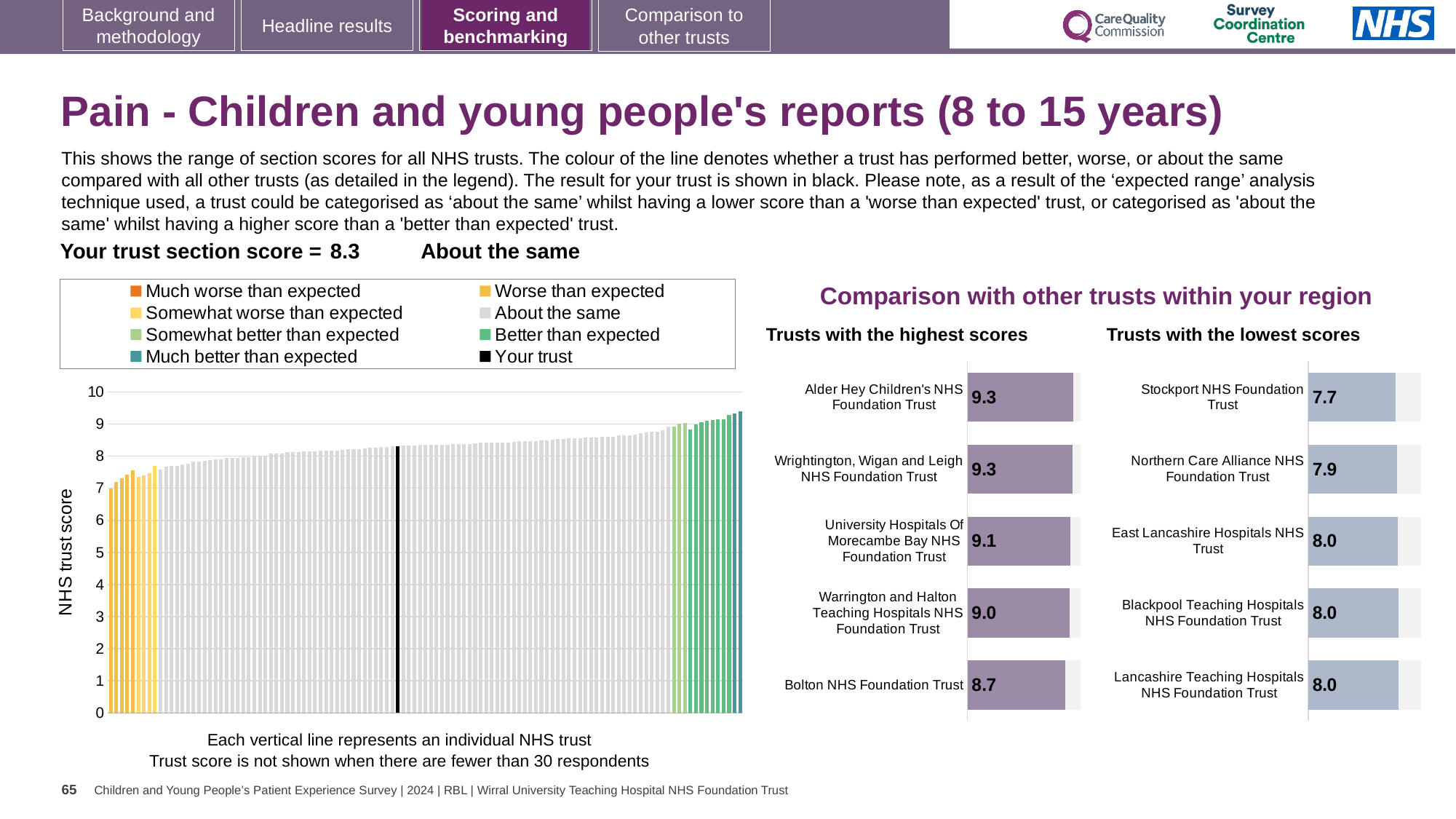
What kind of chart is the NHS trust score chart on the left of the slide? Bar chart In the NHS trust score chart, is the value of the leftmost bar greater or less than 8? less In the 'Trusts with the lowest scores' chart, which trust has the lowest score? Stockport NHS Foundation Trust In the 'Trusts with the lowest scores' chart, what is the difference between the scores of Northern Care Alliance NHS Foundation Trust and Stockport NHS Foundation Trust? 0.2 In the 'Trusts with the highest scores' chart, what is the score for Bolton NHS Foundation Trust? 8.7 In the 'Trusts with the highest scores' chart, what is the difference between the scores of Alder Hey Children's NHS Foundation Trust and Bolton NHS Foundation Trust? 0.6 How many entries does the legend of the NHS trust score chart list? 8 In the 'Trusts with the highest scores' chart, which trust has the lowest score? Bolton NHS Foundation Trust In the NHS trust score chart, do the values rise or fall from left to right? Rise In the 'Trusts with the lowest scores' chart, what is the score for Stockport NHS Foundation Trust? 7.7 In the 'Trusts with the highest scores' chart, which has the higher score: University Hospitals Of Morecambe Bay NHS Foundation Trust or Warrington and Halton Teaching Hospitals NHS Foundation Trust? University Hospitals Of Morecambe Bay NHS Foundation Trust How many trusts are shown in the 'Trusts with the highest scores' chart? 5